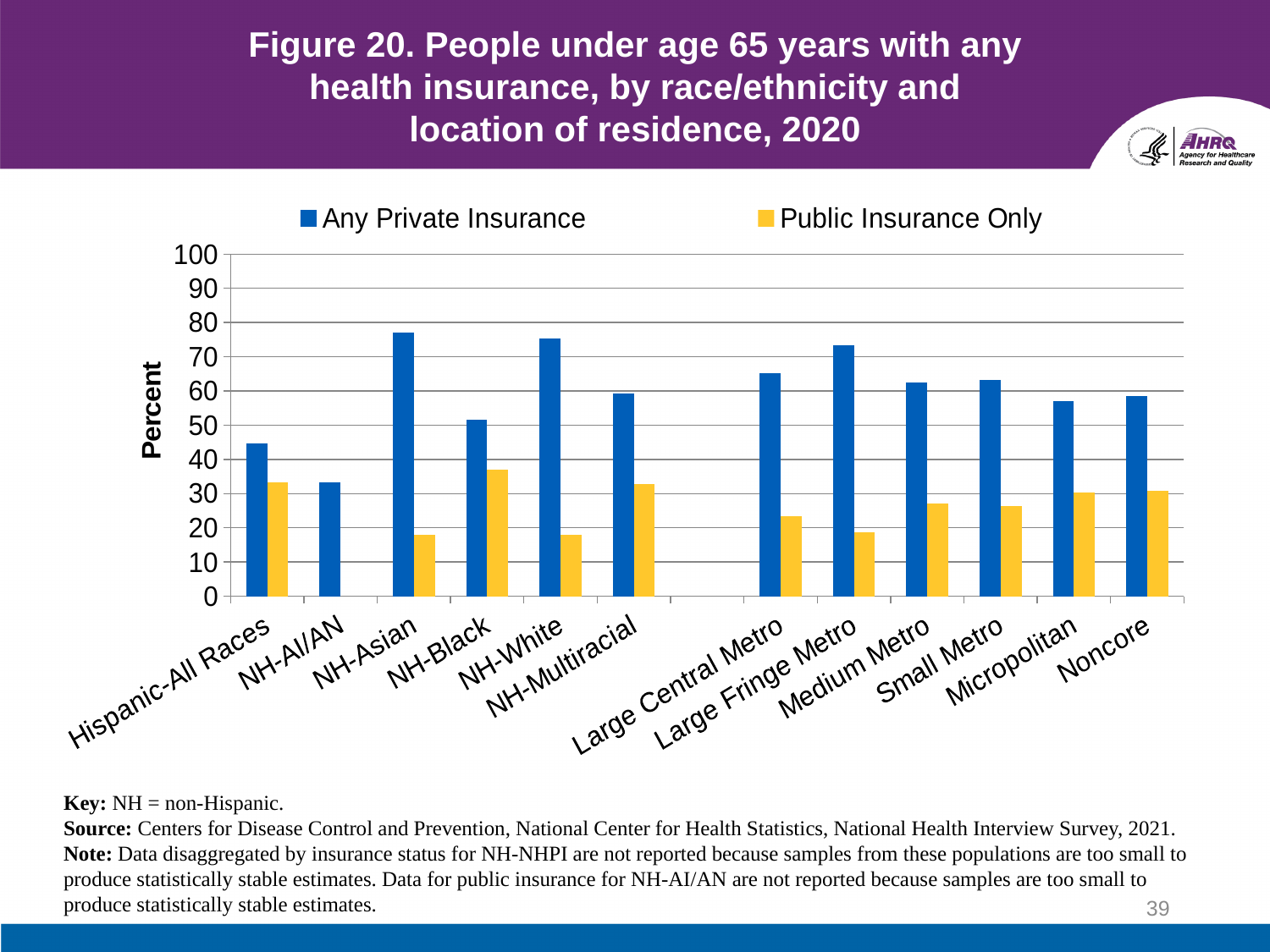
Which category has the highest value for Public Insurance Only? NH-Black How many series does the legend list? 2 Is the Public Insurance Only value for Micropolitan greater or less than 20? greater Which has a larger Public Insurance Only value, Hispanic-All Races or NH-Asian? Hispanic-All Races What kind of chart is shown on the slide? Bar chart What is the label on the vertical axis of the chart? Percent Is the Any Private Insurance value for NH-Asian greater or less than 70? greater Which category has the lowest value for Any Private Insurance? NH-AI/AN Is the Any Private Insurance value for Hispanic-All Races greater or less than 50? less How many race/ethnicity and location categories are labeled on the x axis? 12 Which has a larger Any Private Insurance value, NH-Asian or NH-Black? NH-Asian